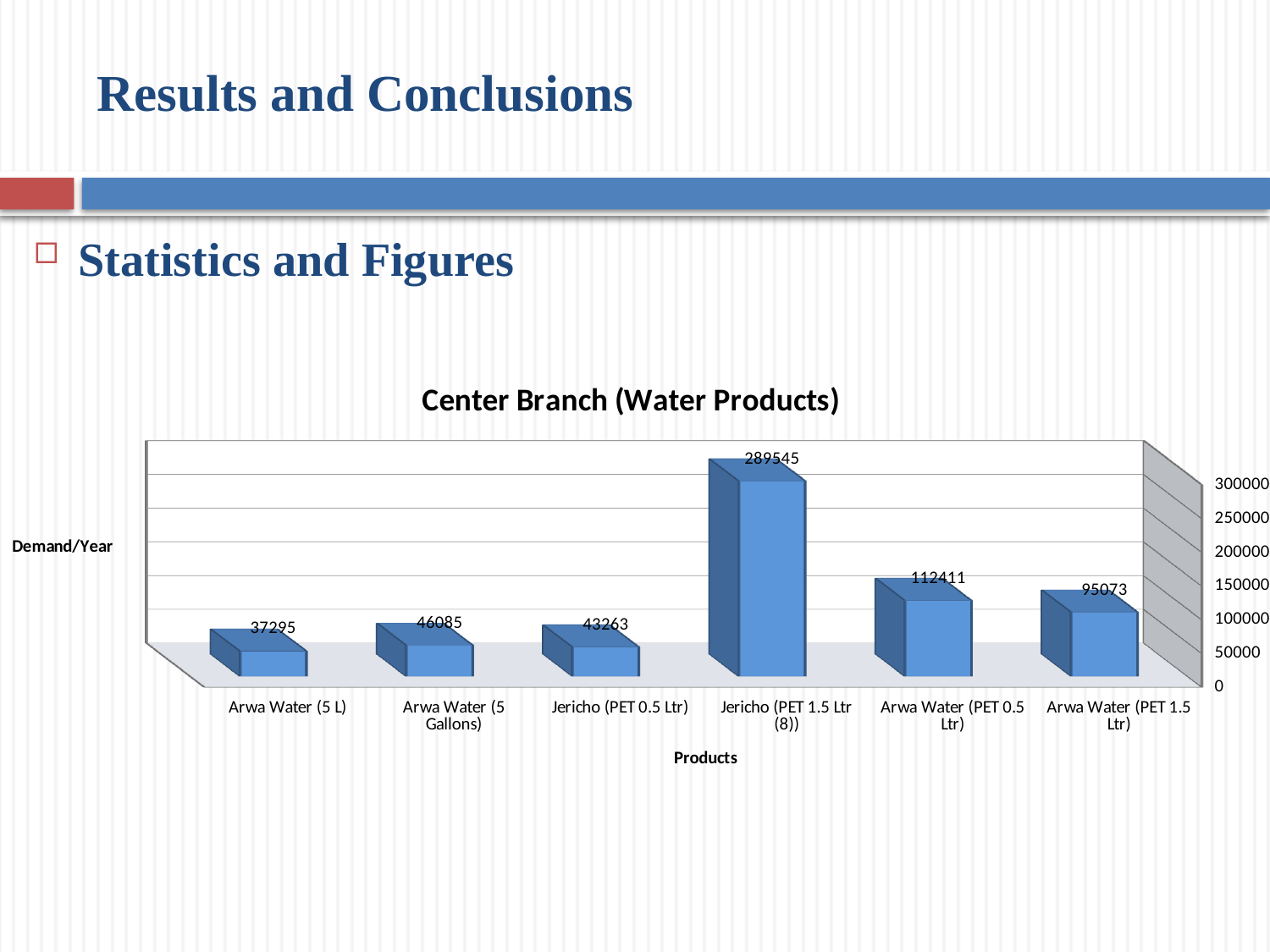
What kind of chart is shown on the slide? Bar chart Which has a higher demand per year, Arwa Water (PET 1.5 Ltr) or Jericho (PET 0.5 Ltr)? Arwa Water (PET 1.5 Ltr) How many products are shown in the chart? 6 Which product has the lowest demand per year? Arwa Water (5 L) What is the demand per year for Arwa Water (PET 0.5 Ltr)? 112411 What is the demand per year for Jericho (PET 1.5 Ltr (8))? 289545 Which product has the highest demand per year? Jericho (PET 1.5 Ltr (8)) What is the difference in demand per year between Arwa Water (5 Gallons) and Jericho (PET 0.5 Ltr)? 2822 What is the demand per year for Arwa Water (5 Gallons)? 46085 Is the value for Arwa Water (PET 1.5 Ltr) greater or less than 100000? less What is the difference in demand per year between Arwa Water (PET 0.5 Ltr) and Arwa Water (PET 1.5 Ltr)? 17338 What is the title of the chart? Center Branch (Water Products)